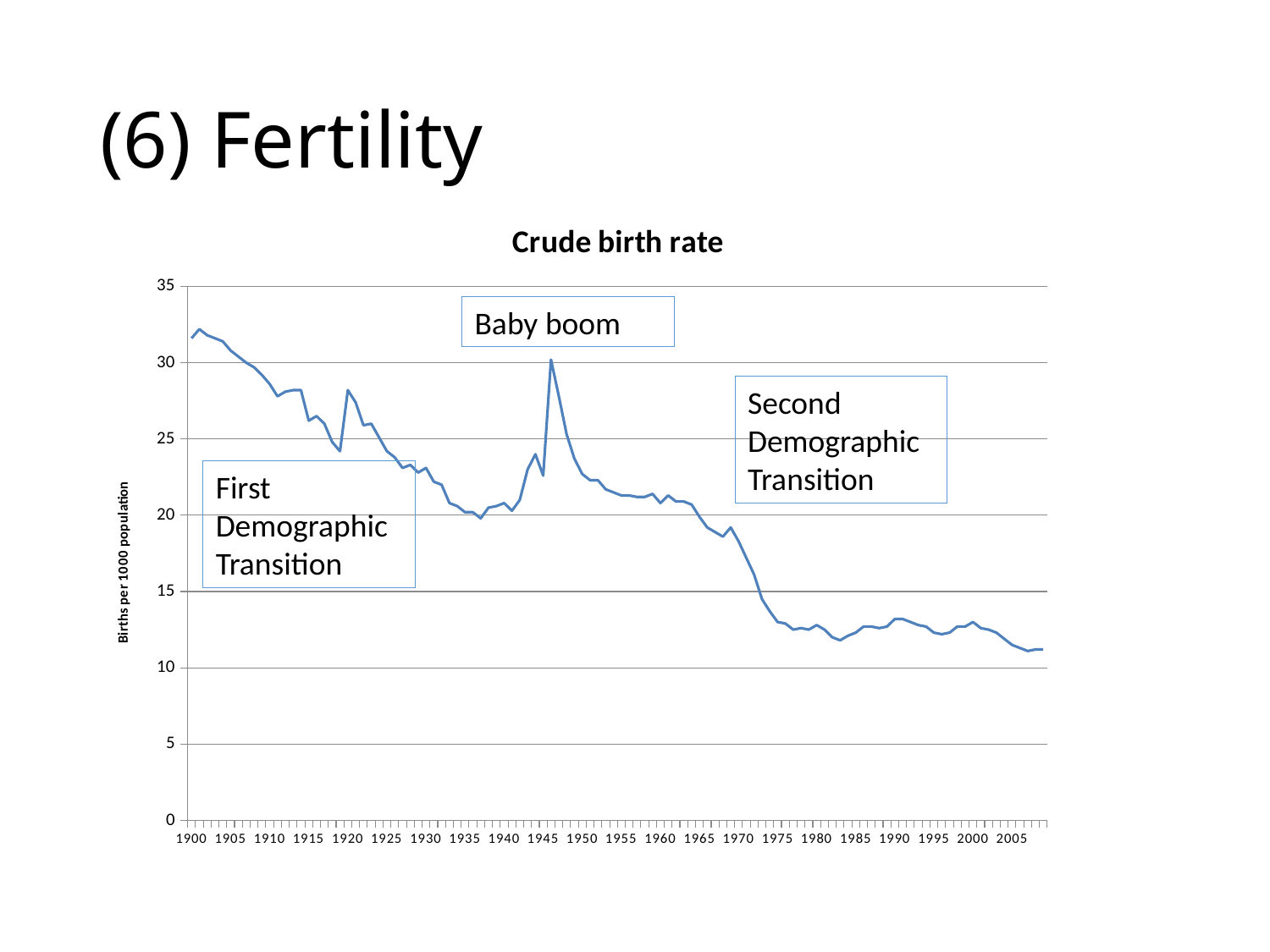
What is the label on the vertical axis of the chart? Births per 1000 population Is the crude birth rate in 1985 greater or less than 10? greater Which is larger, the crude birth rate in 1900 or in 2005? 1900 Between 1970 and 1975, does the crude birth rate rise or fall? fall Is the crude birth rate in 1930 greater or less than 25? less What is the title of the chart? Crude birth rate Overall, does the crude birth rate rise or fall from 1900 to the end of the series? fall What kind of chart is shown on the slide? line chart Is the crude birth rate in 2005 greater or less than 15? less